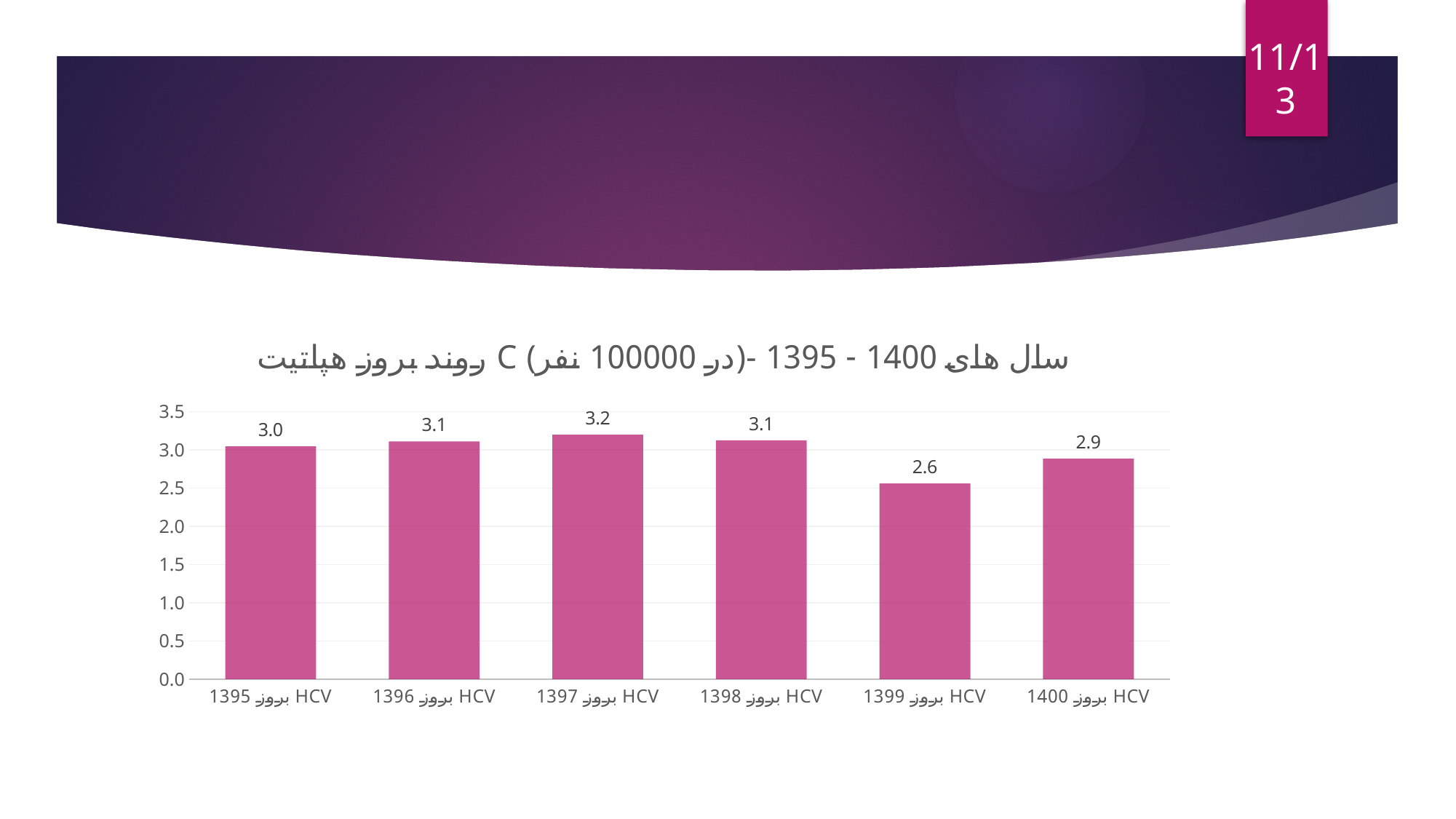
What is the HCV incidence value shown for 1399? 2.6 Which is larger, the HCV incidence value for 1396 or for 1399? 1396 Which year has the highest HCV incidence value? 1397 What is the difference between the HCV incidence values for 1397 and 1399? 0.6 What is the HCV incidence value shown for 1397? 3.2 Is the HCV incidence value for 1399 greater or less than 3.0? less Does the HCV incidence value rise or fall from 1398 to 1399? fall What is the HCV incidence value shown for 1395? 3.0 Which year has the lowest HCV incidence value? 1399 What kind of chart is shown on the slide? bar chart How many years (bars) are shown in the chart? 6 What is the HCV incidence value shown for 1400? 2.9